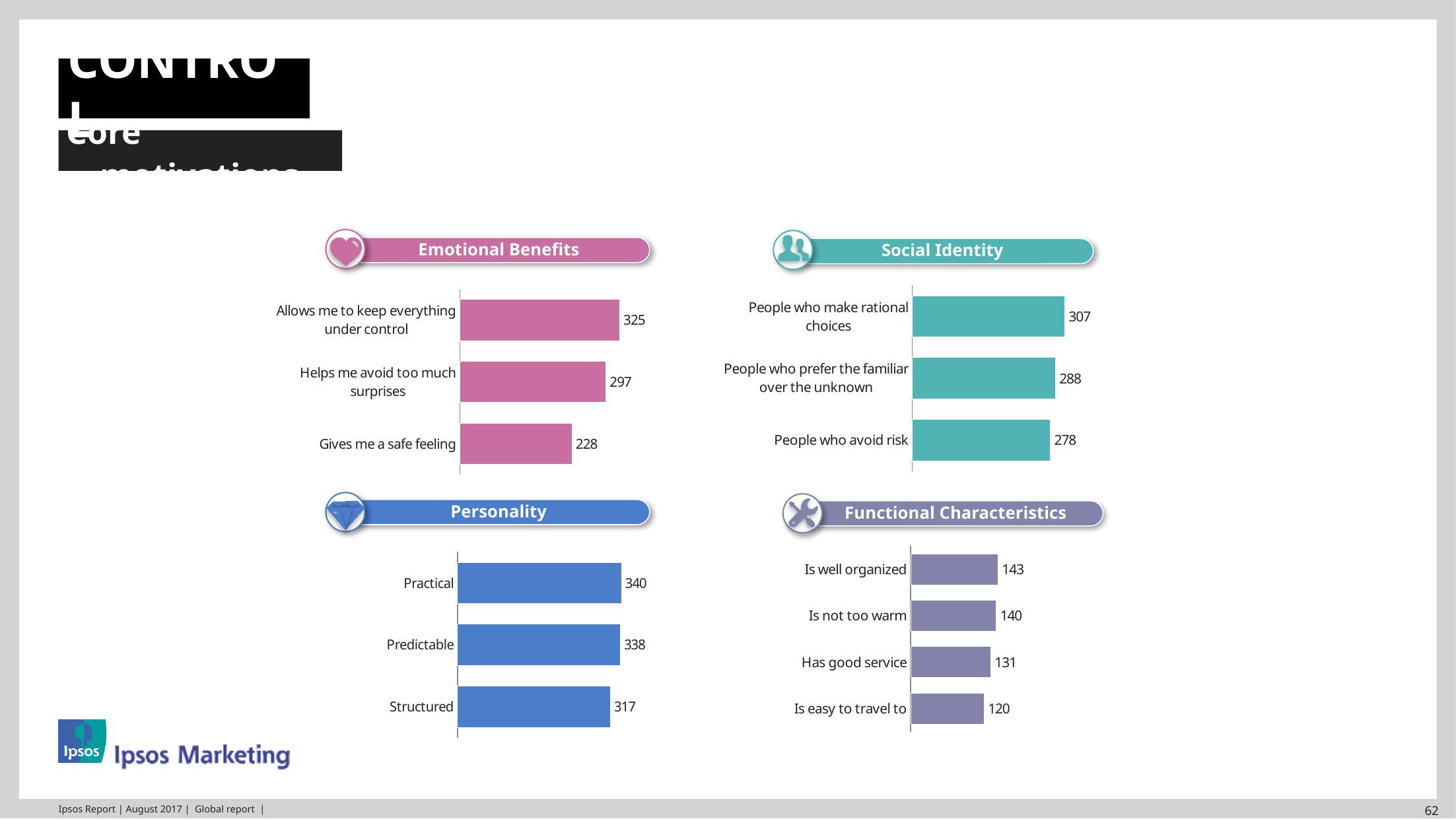
In the Personality chart, what is the difference between "Practical" and "Structured"? 23 In the Emotional Benefits chart, what is the value for "Allows me to keep everything under control"? 325 In the Social Identity chart, which category has the highest value? People who make rational choices In the Personality chart, what is the value for "Structured"? 317 In the Functional Characteristics chart, how many categories are shown? 4 In the Functional Characteristics chart, which category has the lowest value? Is easy to travel to What type of chart is the Personality chart? Bar chart In the Social Identity chart, how many categories are shown? 3 In the Social Identity chart, what is the value for "People who prefer the familiar over the unknown"? 288 In the Emotional Benefits chart, which category has the lowest value? Gives me a safe feeling In the Functional Characteristics chart, what is the value for "Has good service"? 131 In the Emotional Benefits chart, what is the difference between "Helps me avoid too much surprises" and "Gives me a safe feeling"? 69